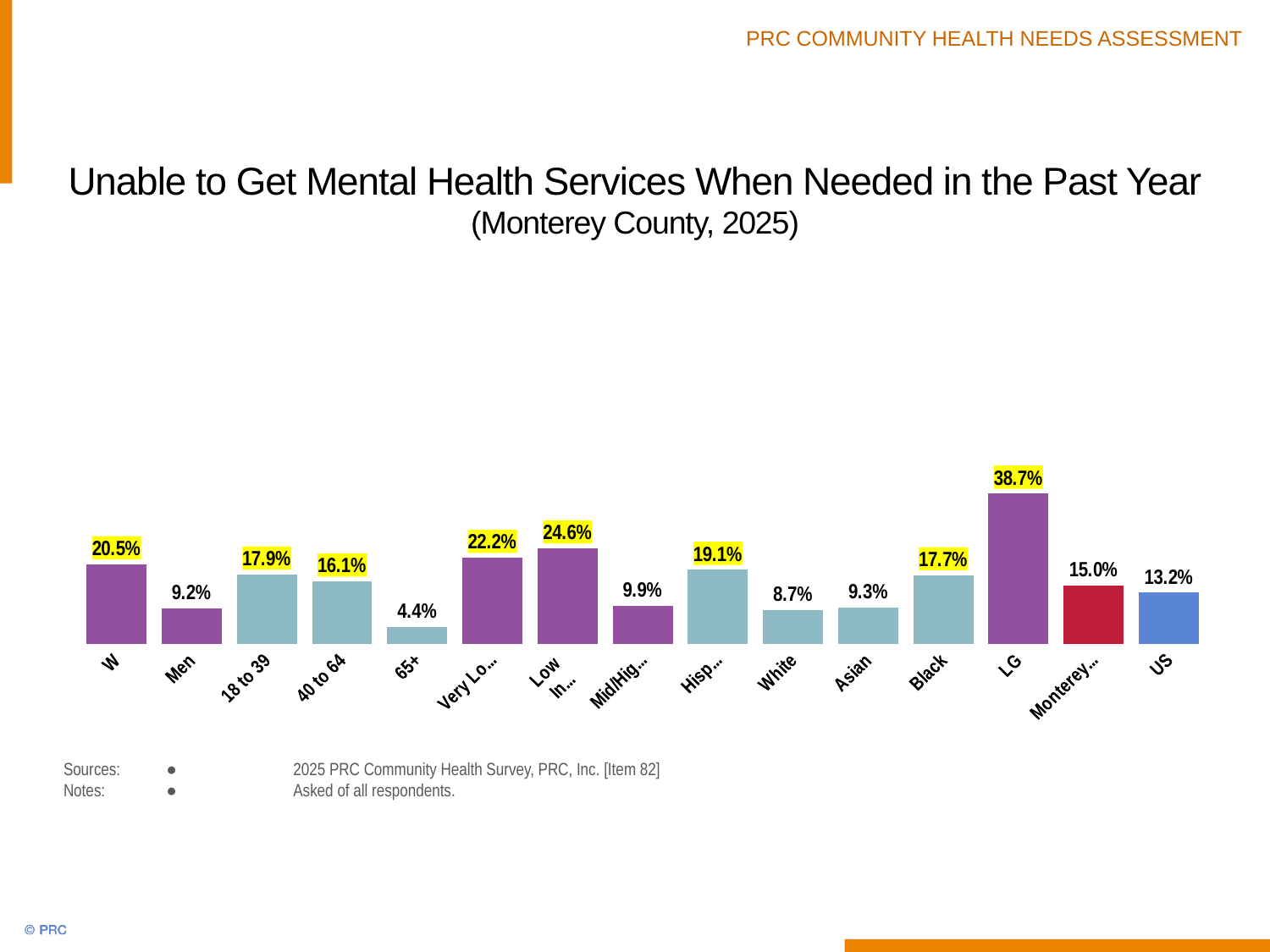
Which is larger, the value for White or the value for Asian? Asian Which category has the highest value? LG What is the value for Black respondents? 17.7% What kind of chart is shown on the slide? bar chart Which category has the lowest value? 65+ What is the value for the 18 to 39 age group? 17.9% How many bars are plotted in the chart? 15 What is the difference between the values for 18 to 39 and 40 to 64? 1.8% What is the difference between the values for Black and the US? 4.5% What is the value for the US? 13.2% What is the value for the 65+ age group? 4.4% What is the value for Men? 9.2%